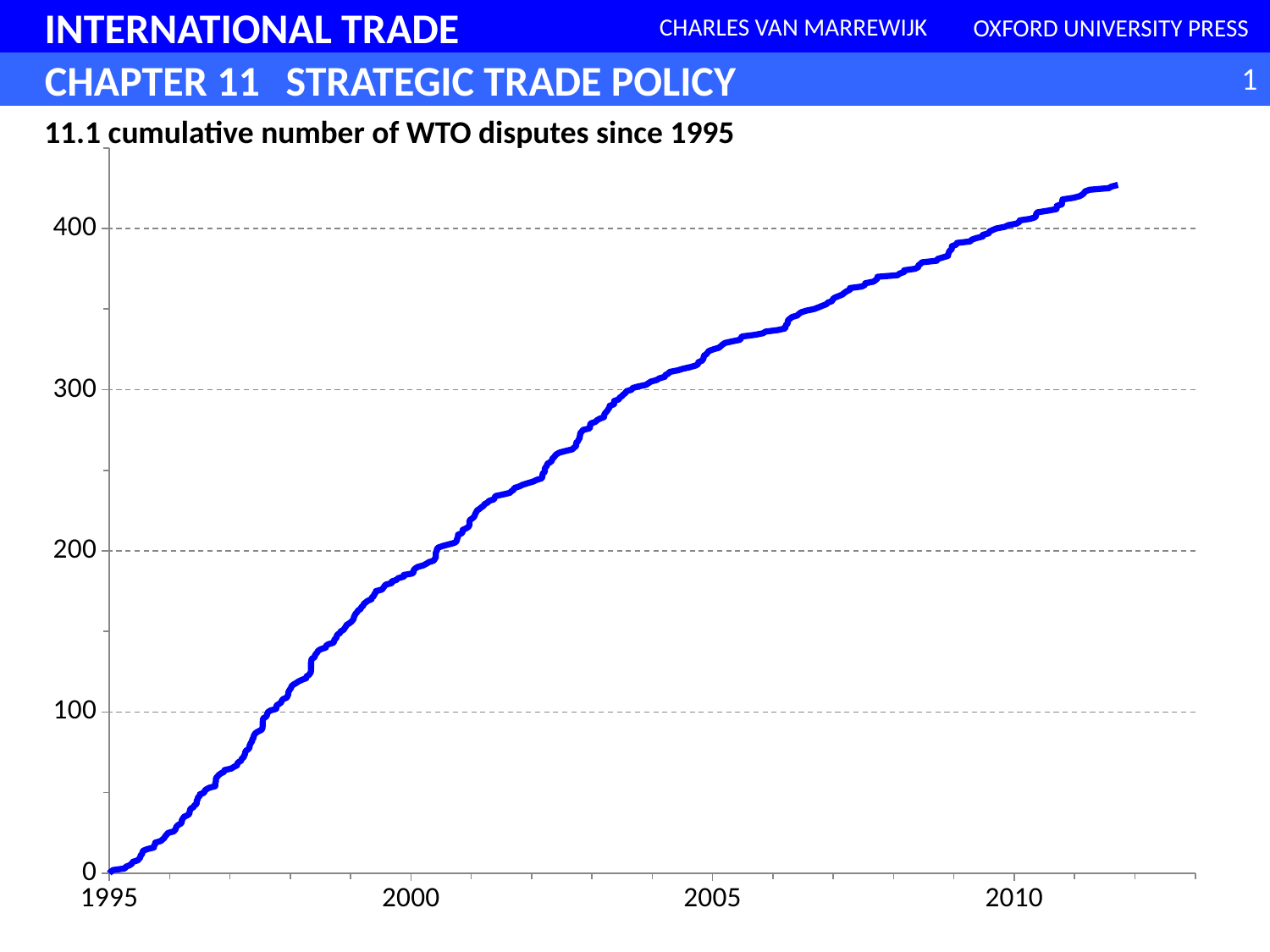
Is the cumulative number of disputes higher in 2010 or in 2000? 2010 Is the cumulative number of disputes at the end of the series (around 2011) greater or less than 400? greater What kind of chart is shown on the slide? line chart Is the cumulative number of disputes in 2005 greater or less than 300? greater Is the cumulative number of disputes in 2010 greater or less than 300? greater What is the cumulative number of WTO disputes at the start of 1995? 0 What is the title of the chart? 11.1 cumulative number of WTO disputes since 1995 Which year shown on the x axis has the lowest cumulative number of disputes? 1995 Do the values rise or fall along the x axis from 1995 to 2011? rise How many year labels are shown on the x axis? 4